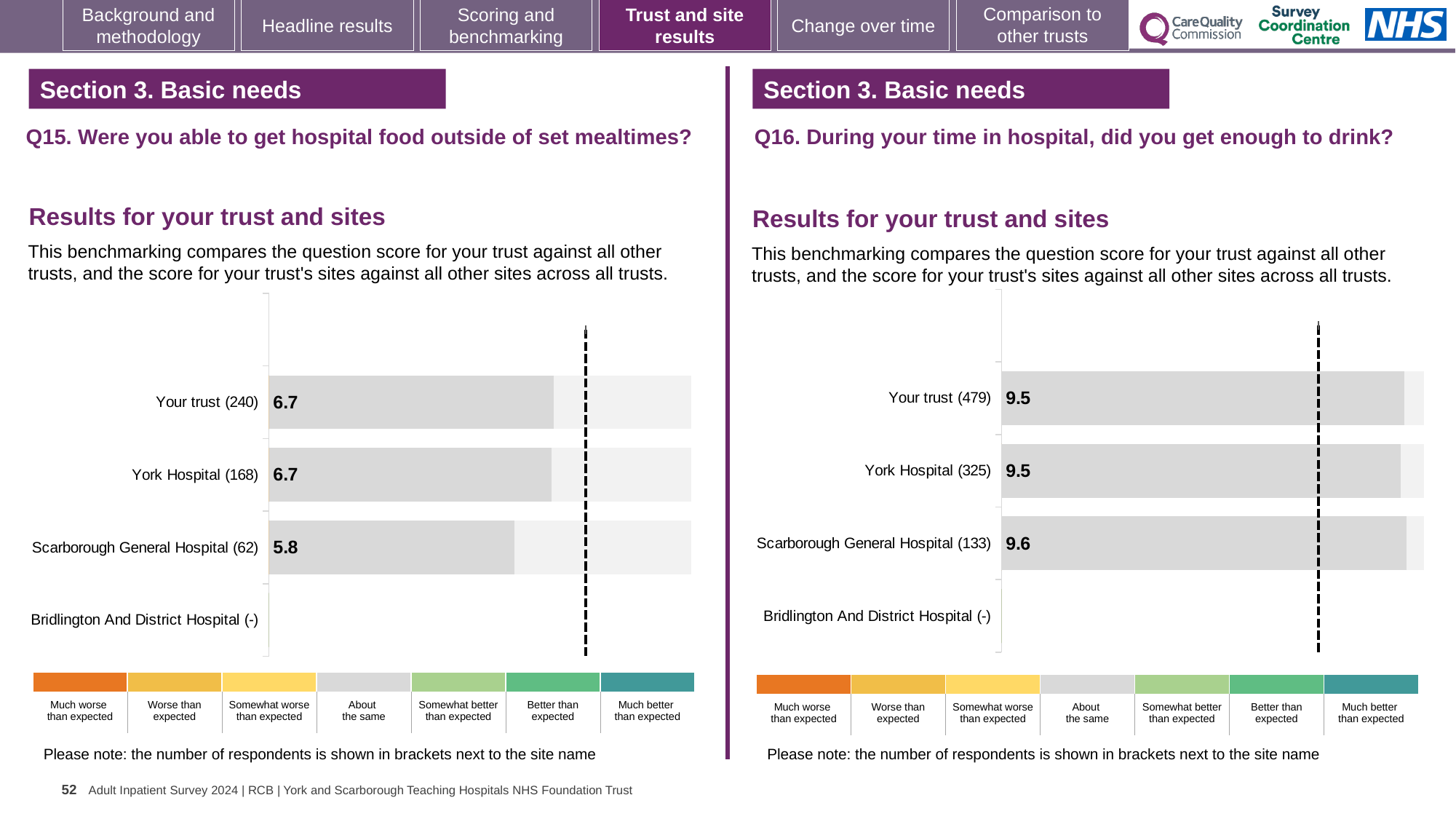
In the Q16 chart (right), how many respondents are shown in brackets for York Hospital? 325 In the Q16 chart (right), what is the score for York Hospital? 9.5 In the Q15 chart (left), which is larger: the score for York Hospital or the score for Scarborough General Hospital? York Hospital In the Q16 chart (right), what is the difference between the Scarborough General Hospital score and the Your trust score? 0.1 In the Q15 chart (left), how many respondents are shown in brackets for Your trust? 240 In the Q16 chart (right), what is the score for Scarborough General Hospital? 9.6 In the Q15 chart (left), what is the difference between the York Hospital score and the Scarborough General Hospital score? 0.9 In the Q15 chart (left), which site has the lowest score? Scarborough General Hospital In the Q15 chart (left), what is the score for Scarborough General Hospital? 5.8 In the Q16 chart (right), how many site rows are listed on the vertical axis? 4 In the Q15 chart (left), what is the score for Your trust? 6.7 What kind of chart is used on the left for Q15? Bar chart